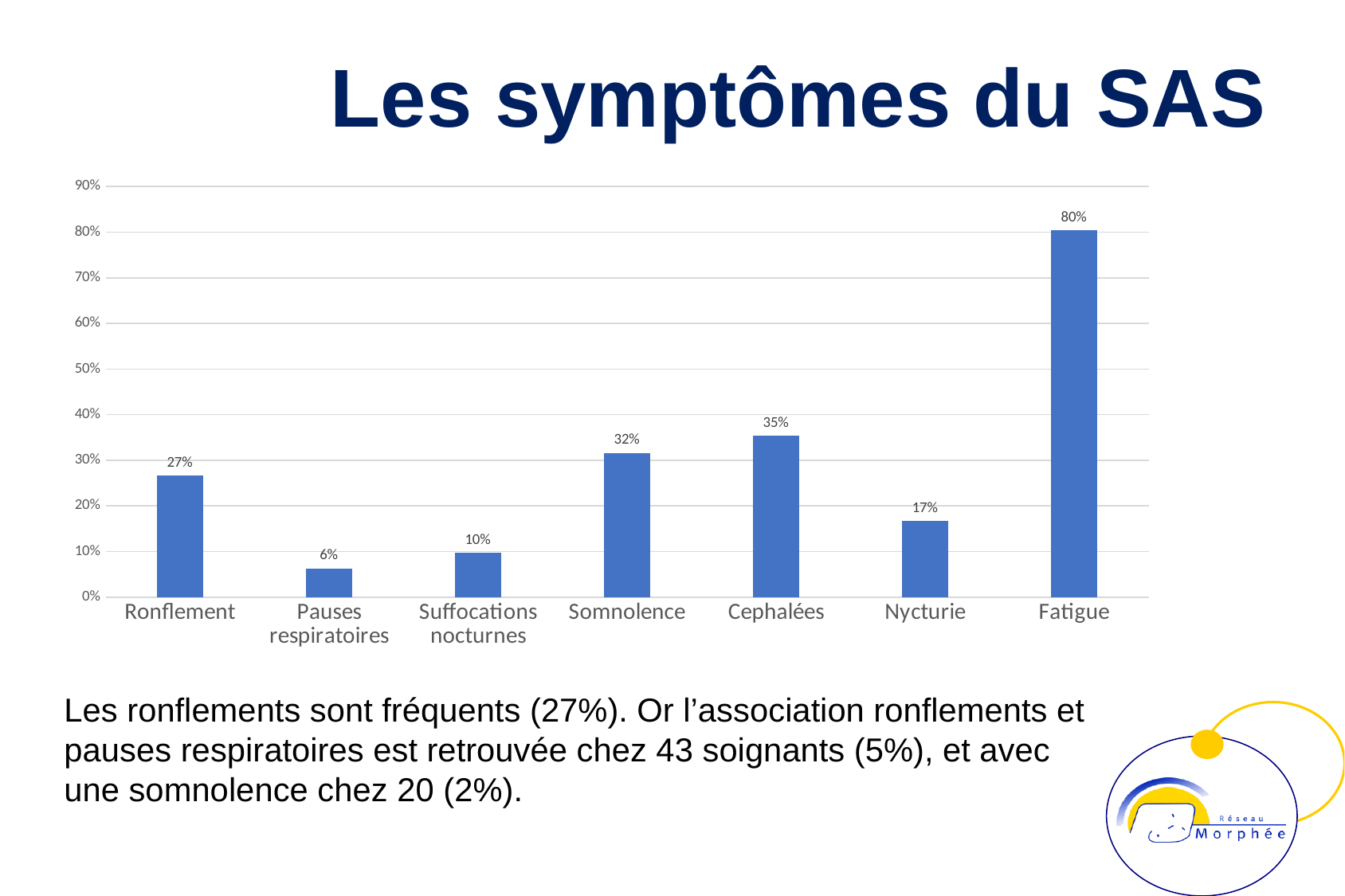
Which symptom has the highest value? Fatigue How many symptom categories are shown on the chart? 7 Which symptom has the lowest value? Pauses respiratoires What is the value for Fatigue? 80% What is the value for Nycturie? 17% What is the difference between the values for Fatigue and Cephalées? 45% What is the value for Somnolence? 32% What kind of chart is shown on the slide? bar chart Is the value for Suffocations nocturnes greater or less than 20%? less What is the value for Pauses respiratoires? 6% Which is larger, the value for Ronflement or the value for Somnolence? Somnolence What is the title of the slide containing the chart? Les symptômes du SAS